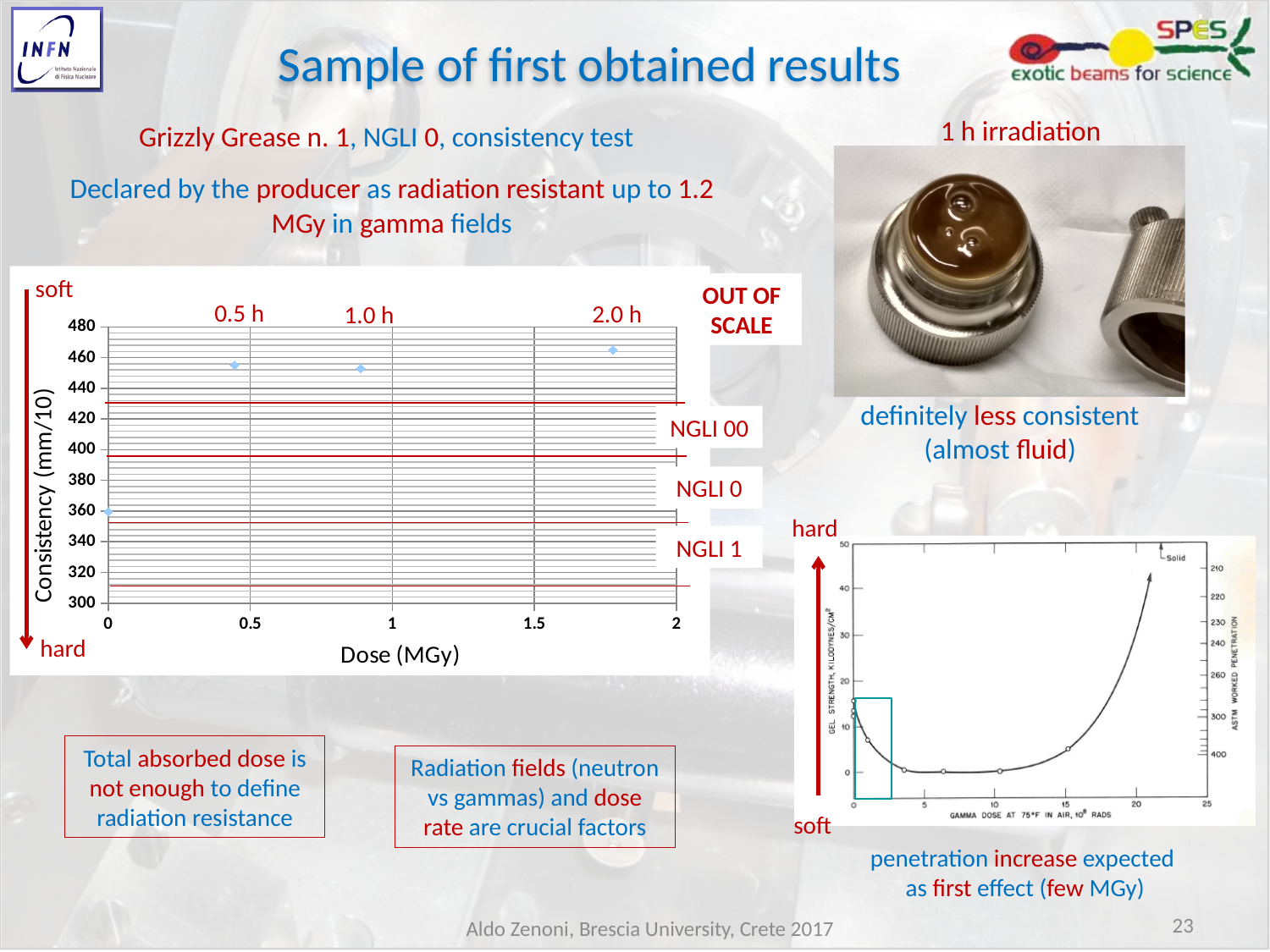
In the Consistency vs Dose chart, is the consistency value for the 0.5 h point greater or less than 440? greater In the Consistency vs Dose chart, how many data points are plotted? 4 In the Consistency vs Dose chart, which point has the highest consistency value? 2.0 h In the Consistency vs Dose chart, is the consistency value at dose 0 greater or less than 400? less In the Consistency vs Dose chart, which point has the lowest consistency value? the point at dose 0 In the Consistency vs Dose chart, which has the larger consistency value: the point at dose 0 or the 0.5 h point? 0.5 h In the Consistency vs Dose chart, is the consistency value for the 1.0 h point greater or less than 440? greater In the Consistency vs Dose chart, does the consistency rise or fall from dose 0 to the 0.5 h point? rise In the Consistency vs Dose chart, what is the title of the x axis? Dose (MGy) In the Consistency vs Dose chart, what is the title of the y axis? Consistency (mm/10) In the Consistency vs Dose chart, what kind of chart is used to plot the measurements? scatter chart